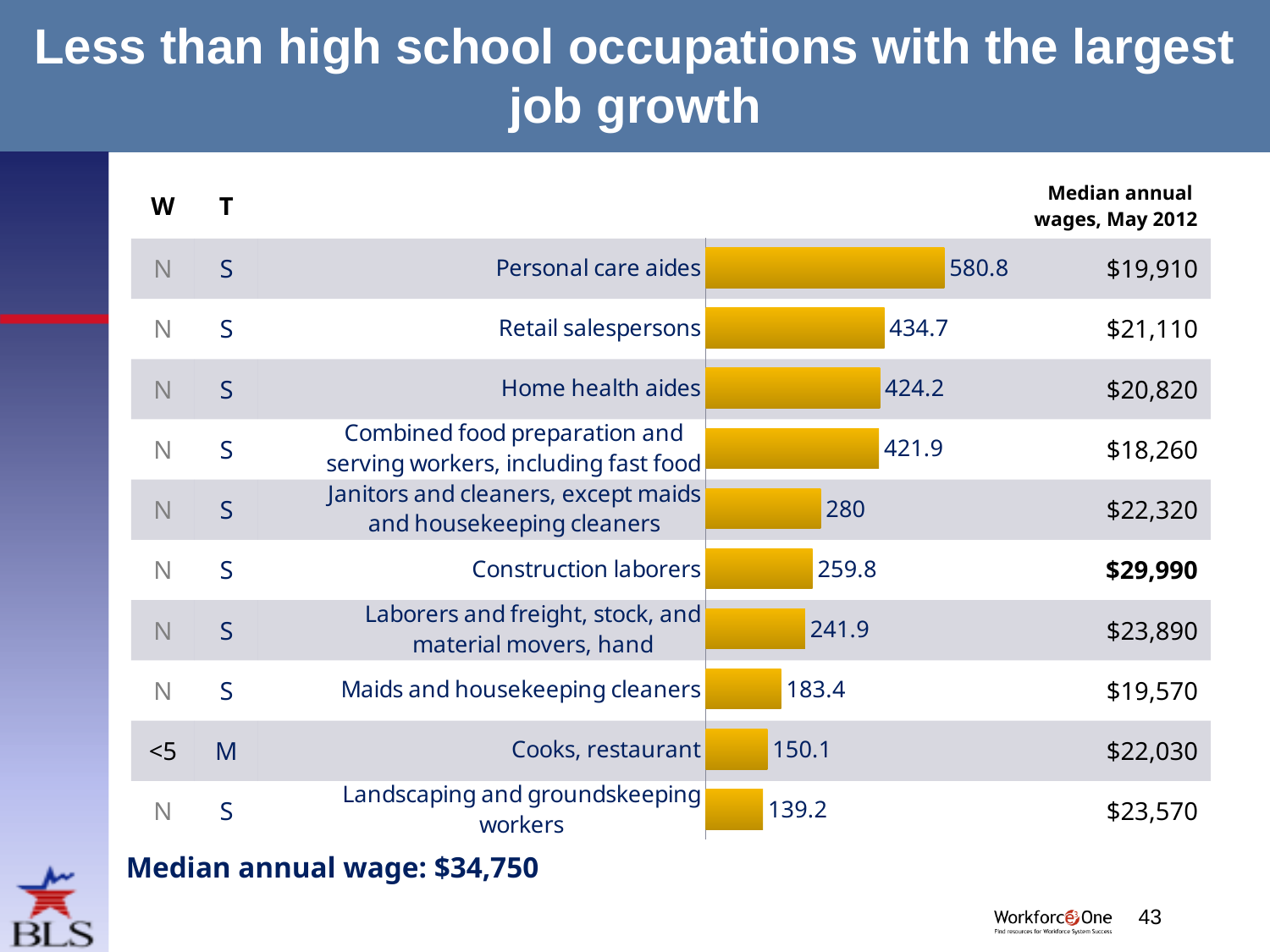
Which has a larger value, Construction laborers or Home health aides? Home health aides Do the bar values increase or decrease going from the top of the chart to the bottom? Decrease What is the difference between the values for Personal care aides and Retail salespersons? 146.1 How many occupations are shown in the chart? 10 What is the value for Personal care aides? 580.8 What is the difference between the values for Maids and housekeeping cleaners and Cooks, restaurant? 33.3 What is the value for Janitors and cleaners, except maids and housekeeping cleaners? 280 Which occupation has the lowest value? Landscaping and groundskeeping workers What kind of chart is shown on the slide? Bar chart Which occupation has the highest value? Personal care aides What is the value for Laborers and freight, stock, and material movers, hand? 241.9 What is the value for Cooks, restaurant? 150.1